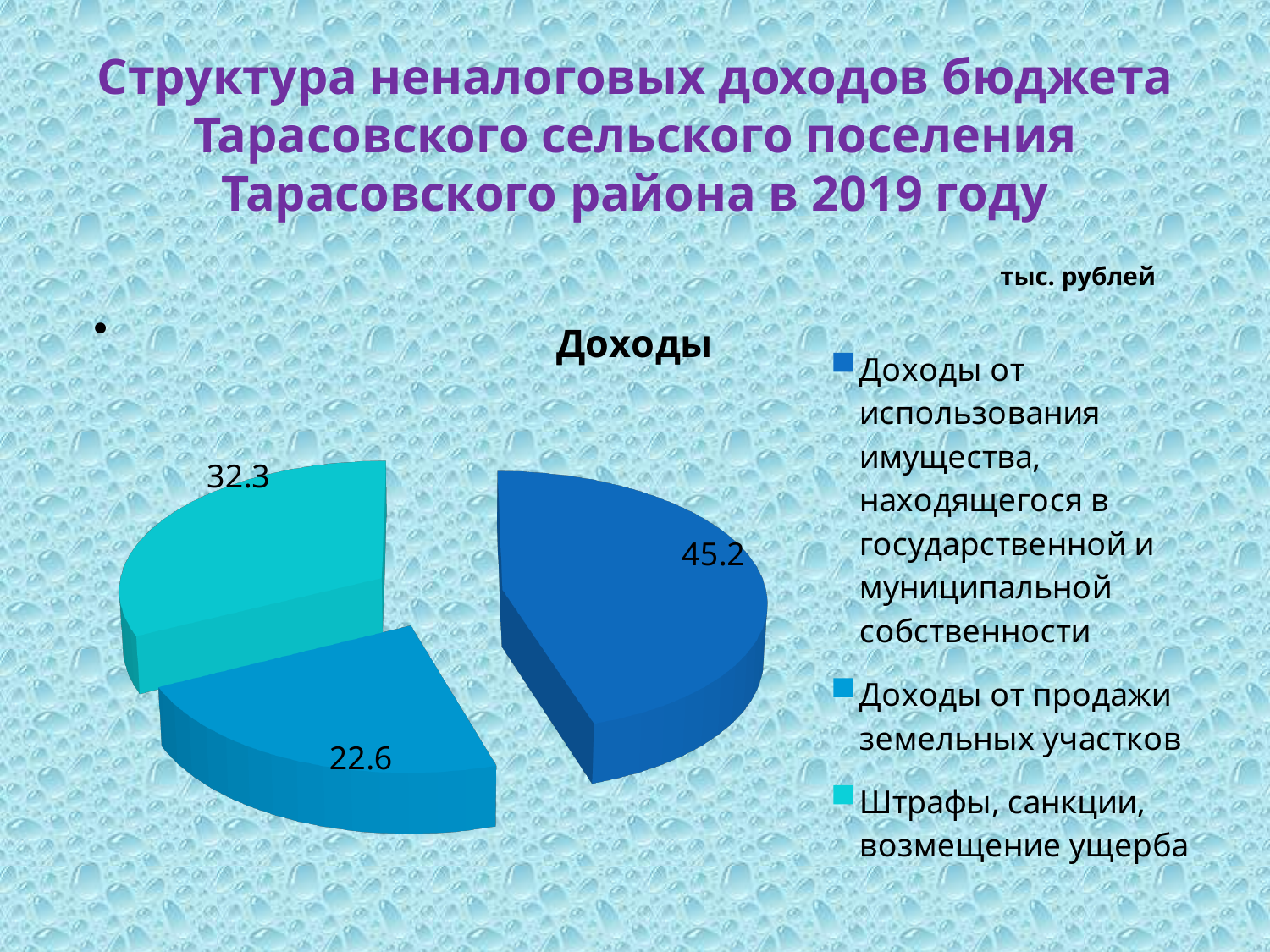
How many slices does the pie chart have? 3 How many entries does the legend list? 3 What is the value for 'Доходы от использования имущества, находящегося в государственной и муниципальной собственности'? 45.2 In what units are the values on the chart given, according to the slide? тыс. рублей What type of chart is shown on the slide? Pie chart Which category has the largest value in the pie chart? Доходы от использования имущества, находящегося в государственной и муниципальной собственности Which category has the smallest value in the pie chart? Доходы от продажи земельных участков Which is larger: the value for 'Штрафы, санкции, возмещение ущерба' or the value for 'Доходы от продажи земельных участков'? Штрафы, санкции, возмещение ущерба What is the value for 'Доходы от продажи земельных участков'? 22.6 What is the value for 'Штрафы, санкции, возмещение ущерба'? 32.3 What is the difference between the value for 'Доходы от использования имущества' and the value for 'Доходы от продажи земельных участков'? 22.6 What is the title of the chart? Доходы